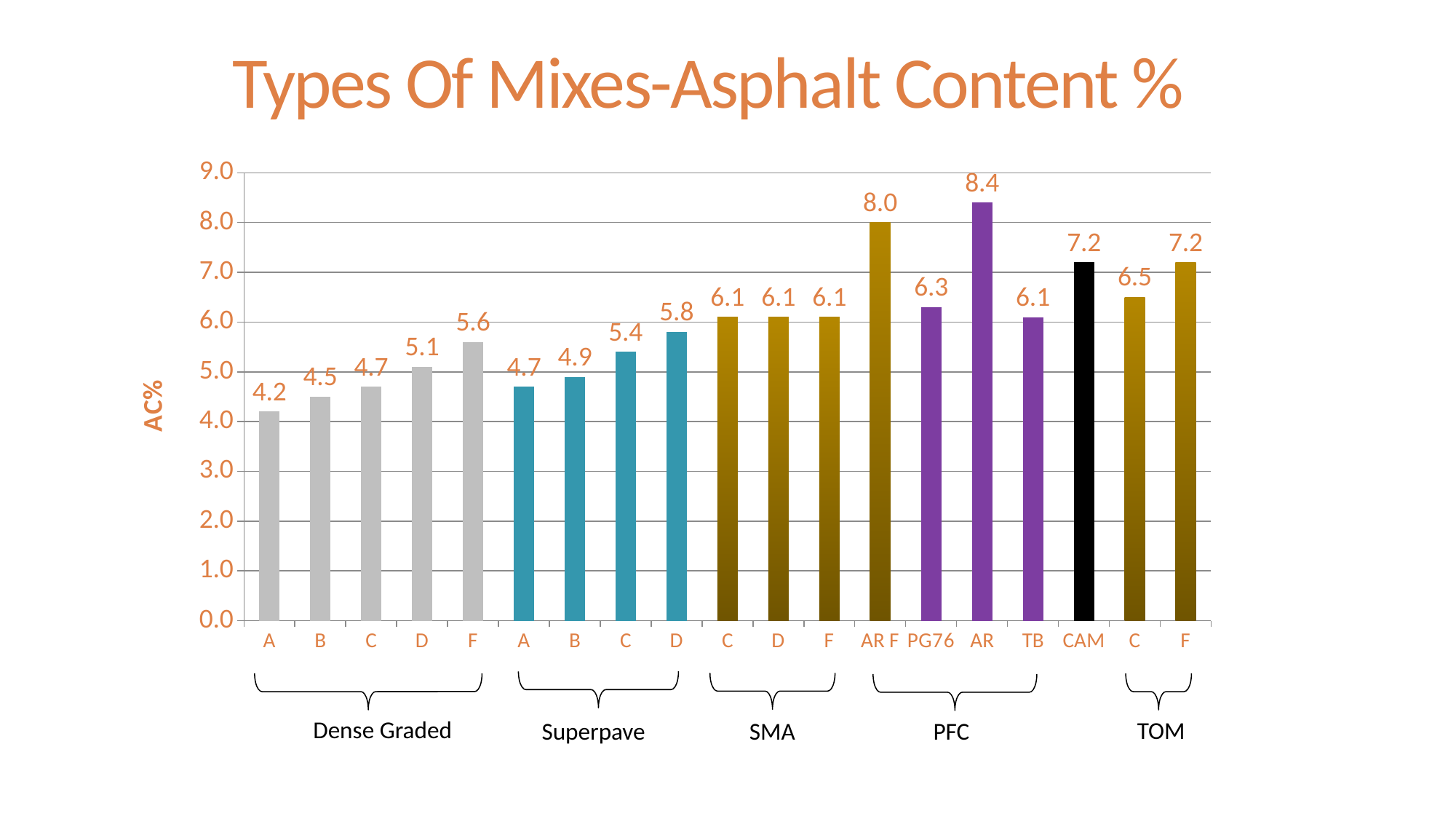
What is the asphalt content for the PFC AR mix? 8.4 How many bars are plotted in the chart? 19 What is the difference in asphalt content between PFC AR and Dense Graded A? 4.2 Which bar has the highest asphalt content? PFC AR What is the label on the vertical axis? AC% Which bar has the lowest asphalt content? Dense Graded A What type of chart is shown on the slide? Bar chart What is the asphalt content for Superpave mix D? 5.8 What is the asphalt content for Dense Graded mix A? 4.2 What is the difference in asphalt content between TOM F and TOM C? 0.7 What is the asphalt content for CAM? 7.2 Which has a higher asphalt content, PFC AR F or PFC PG76? PFC AR F